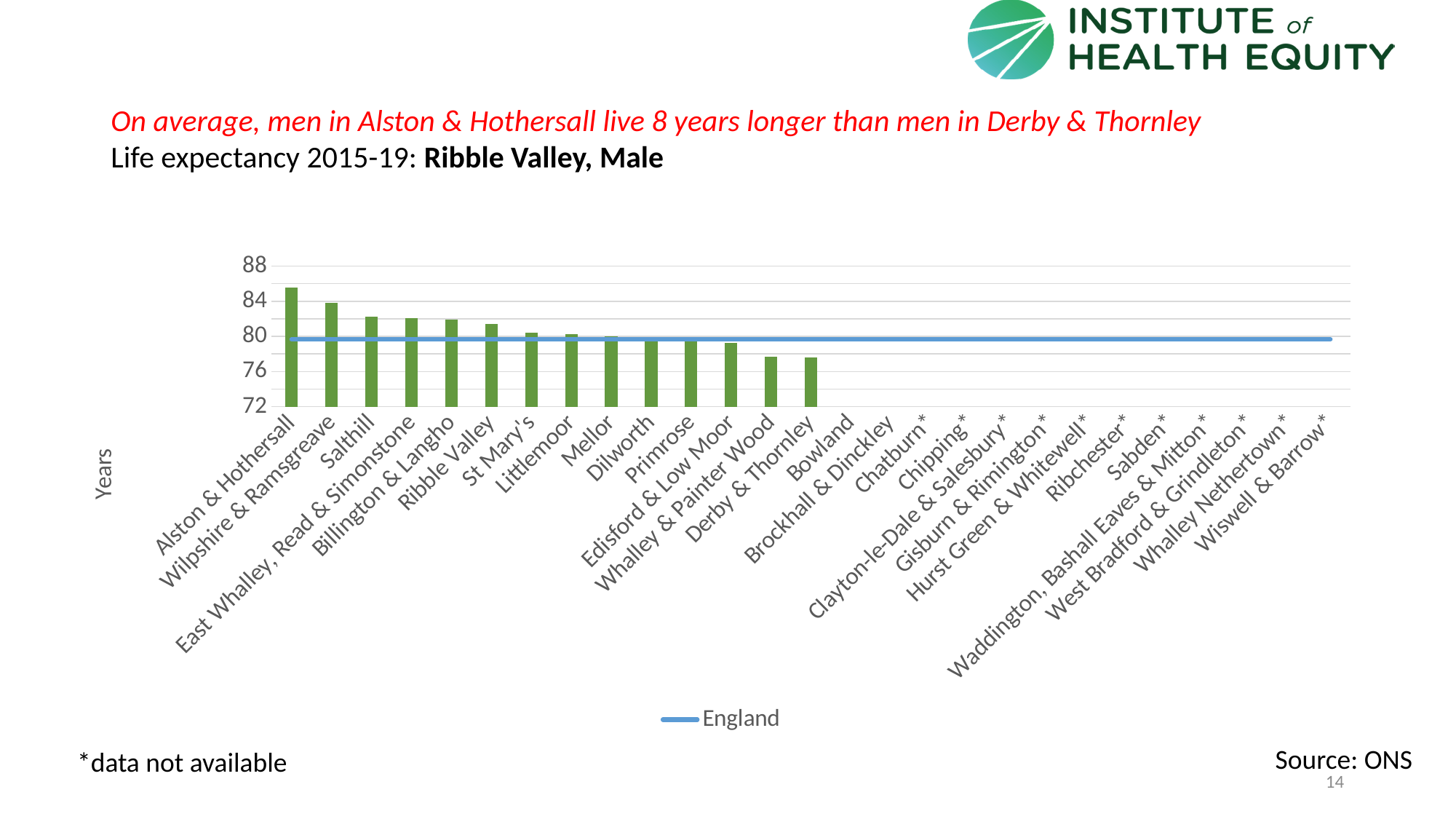
Is the value for Salthill greater or less than 80? greater Is the value for Alston & Hothersall greater or less than 84? greater Is the value for Derby & Thornley greater or less than 80? less What series does the legend identify for the horizontal line? England What kind of chart is shown on the slide? Bar chart Which area has the highest male life expectancy in the chart? Alston & Hothersall Do the bar values rise or fall from left to right along the x axis? Fall Which is larger, the value for Ribble Valley or the value for Derby & Thornley? Ribble Valley Which area with a plotted bar has the lowest male life expectancy? Derby & Thornley Which is larger, the value for Alston & Hothersall or the value for Salthill? Alston & Hothersall How many areas have a bar plotted in the chart? 14